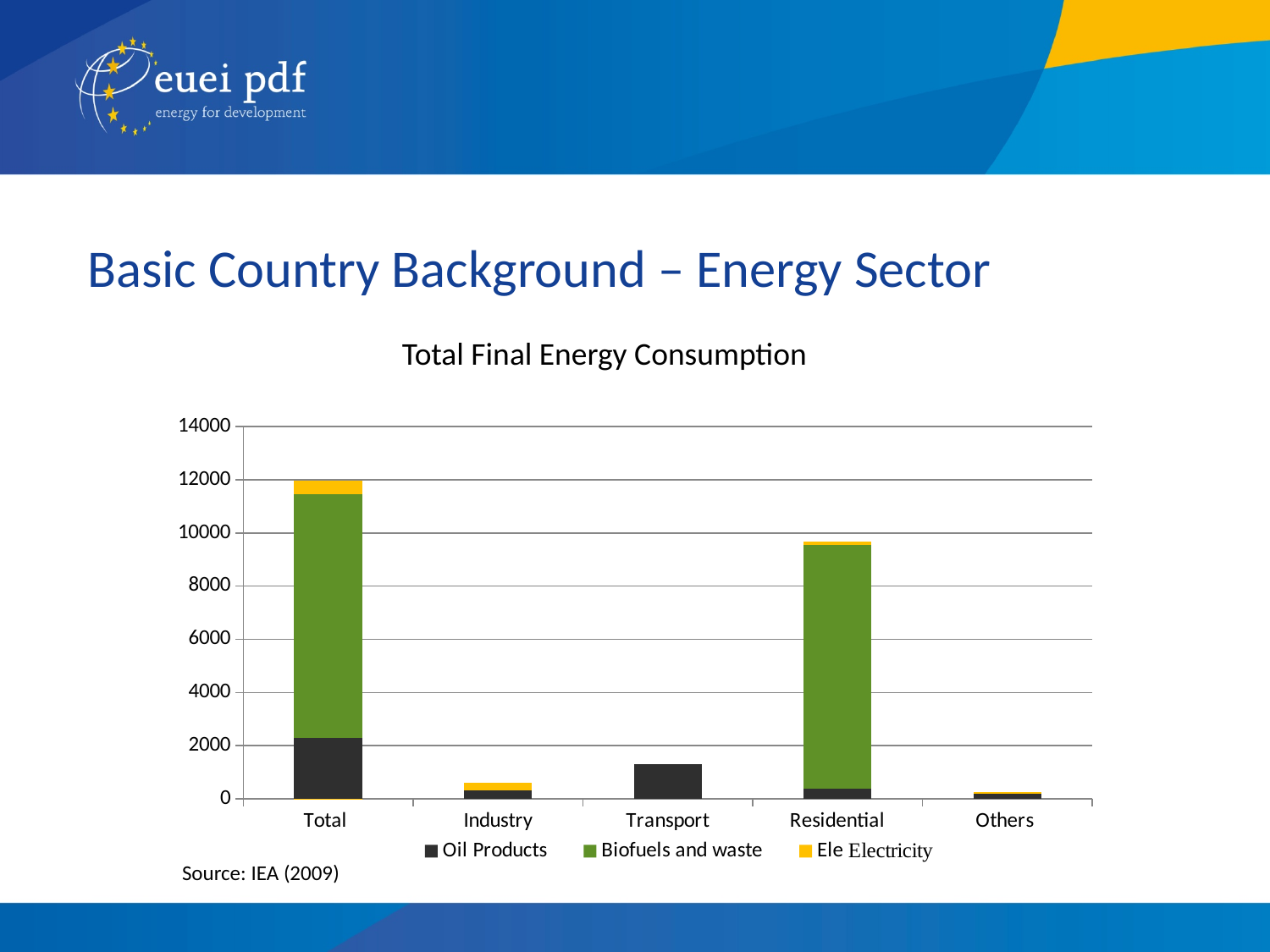
In the Total bar, which segment is larger, Oil Products or Biofuels and waste? Biofuels and waste Which category has the highest stacked bar? Total Which category has the lowest stacked bar? Others Is the total stacked value for Residential greater or less than 8000? greater What source is cited below the chart? IEA (2009) Which category has the larger stacked bar, Residential or Industry? Residential What type of chart is shown on the slide? Stacked bar chart Is the total stacked value for Total greater or less than 10000? greater What is the title of the chart? Total Final Energy Consumption Is the total stacked value for Transport greater or less than 2000? less How many categories are shown on the x axis of the chart? 5 How many series does the chart legend list? 3